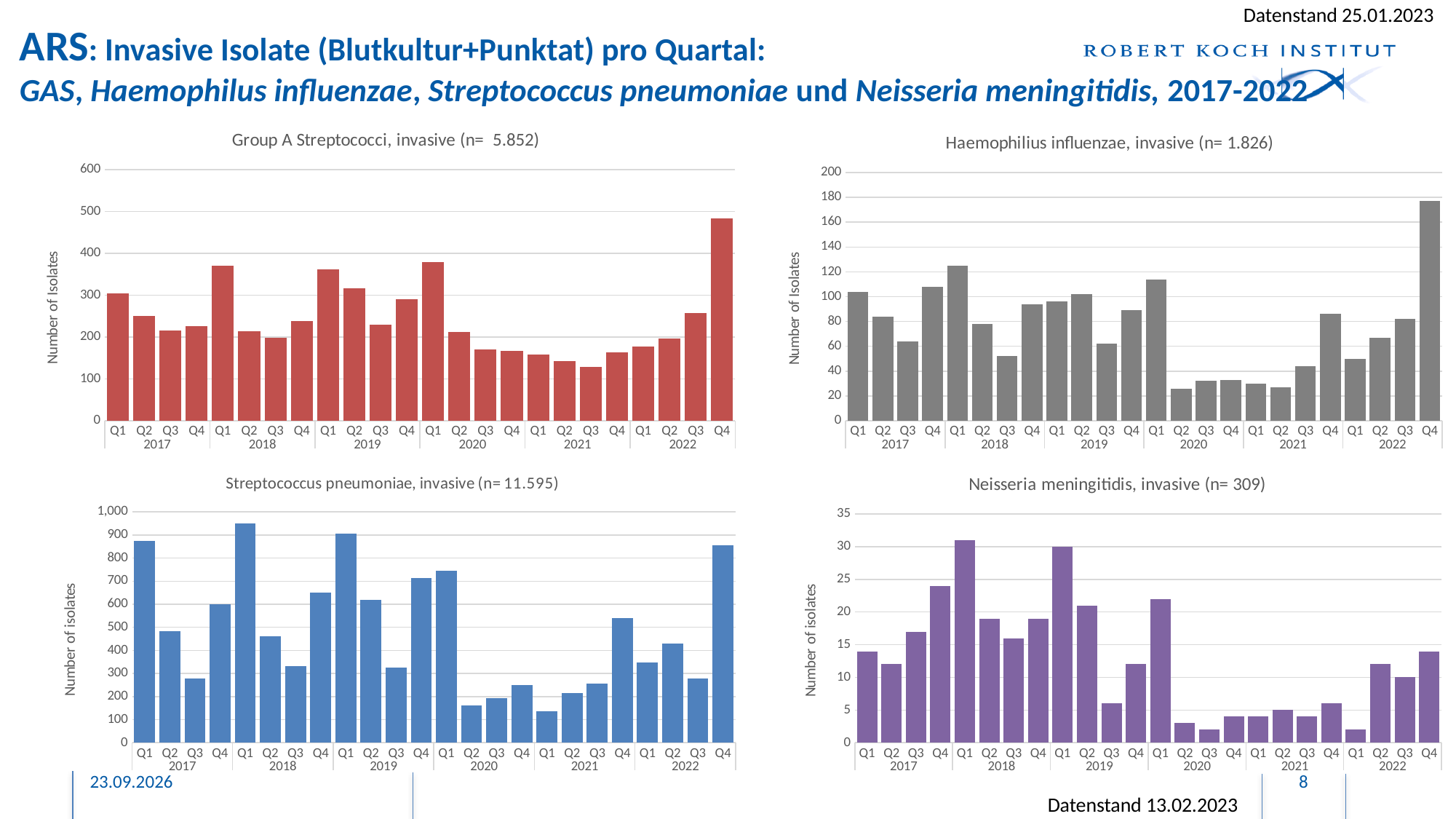
In the Haemophilius influenzae, invasive chart, do the values rise or fall from Q1 2022 to Q4 2022? rise In the Haemophilius influenzae, invasive chart, is the value for Q1 2018 greater or less than 120? greater In the Streptococcus pneumoniae, invasive chart, which quarter has the lowest number of isolates? Q1 2021 What total n is given in the title of the Neisseria meningitidis, invasive chart? 309 In the Neisseria meningitidis, invasive chart, is the value for Q1 2020 greater or less than 20? greater In the Group A Streptococci, invasive chart, is the value for Q4 2022 greater or less than 400? greater In the Streptococcus pneumoniae, invasive chart, which is larger, the value for Q4 2022 or the value for Q4 2021? Q4 2022 In the Group A Streptococci, invasive chart, which quarter has the highest number of isolates? Q4 2022 In the Streptococcus pneumoniae, invasive chart, which quarter has the highest number of isolates? Q1 2018 What kind of chart is the Group A Streptococci, invasive chart? bar chart In the Haemophilius influenzae, invasive chart, which quarter has the highest number of isolates? Q4 2022